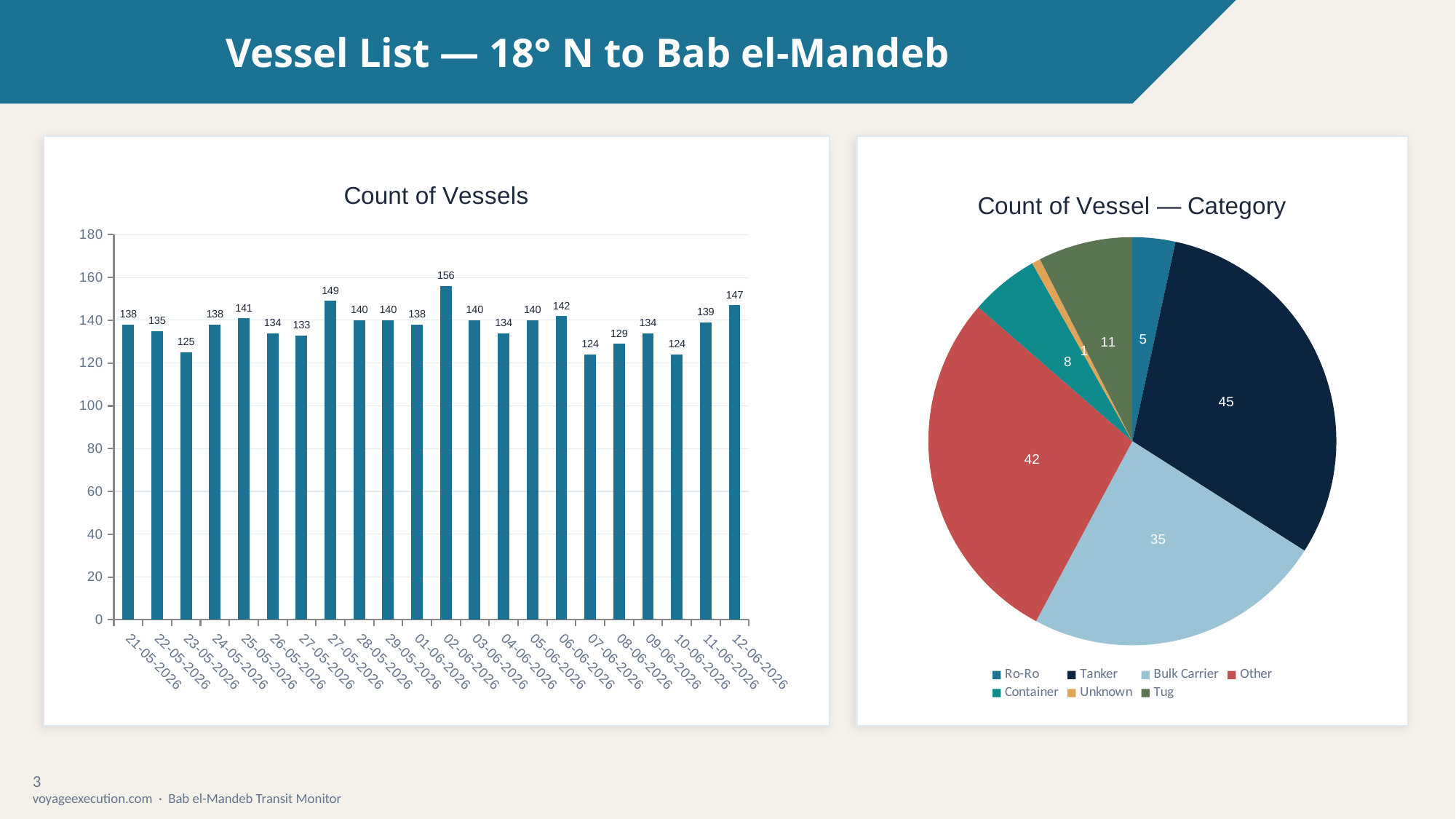
On the Count of Vessels bar chart, which date has the highest count? 02-06-2026 On the Count of Vessel — Category pie chart, what is the difference between Other and Bulk Carrier? 7 On the Count of Vessel — Category pie chart, what is the value for Tanker? 45 On the Count of Vessels bar chart, what is the value for 02-06-2026? 156 On the Count of Vessel — Category pie chart, which category has the smallest slice? Unknown How many categories does the legend of the Count of Vessel — Category pie chart list? 7 On the Count of Vessels bar chart, which is larger, the value for 25-05-2026 or the value for 26-05-2026? 25-05-2026 On the Count of Vessels bar chart, what is the lowest value shown? 124 On the Count of Vessels bar chart, what is the value for 23-05-2026? 125 How many bars are plotted on the Count of Vessels bar chart? 22 What kind of chart is the Count of Vessels chart on the left? Bar chart On the Count of Vessels bar chart, what is the difference between the values for 12-06-2026 and 10-06-2026? 23